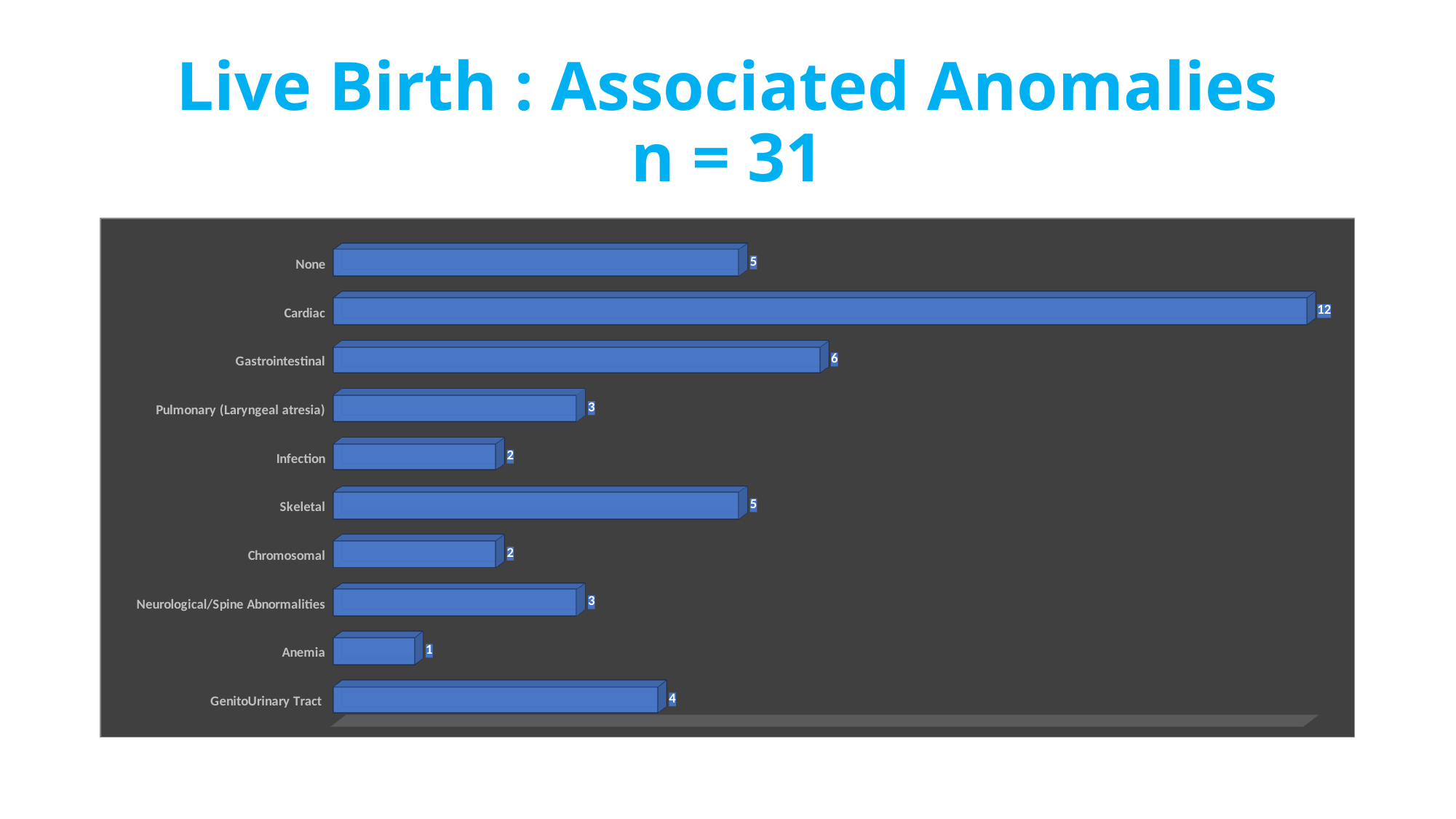
What is the difference between the values for None and Infection? 3 Which category has the highest value? Cardiac What is the value for GenitoUrinary Tract? 4 What kind of chart is shown on the slide? Bar chart How many categories are shown in the chart? 10 What is the title of the slide? Live Birth : Associated Anomalies n = 31 Which is larger, the value for Skeletal or the value for GenitoUrinary Tract? Skeletal What is the value for Cardiac? 12 What is the value for Gastrointestinal? 6 What is the value for Anemia? 1 What is the difference between the values for Cardiac and Gastrointestinal? 6 Which category has the lowest value? Anemia